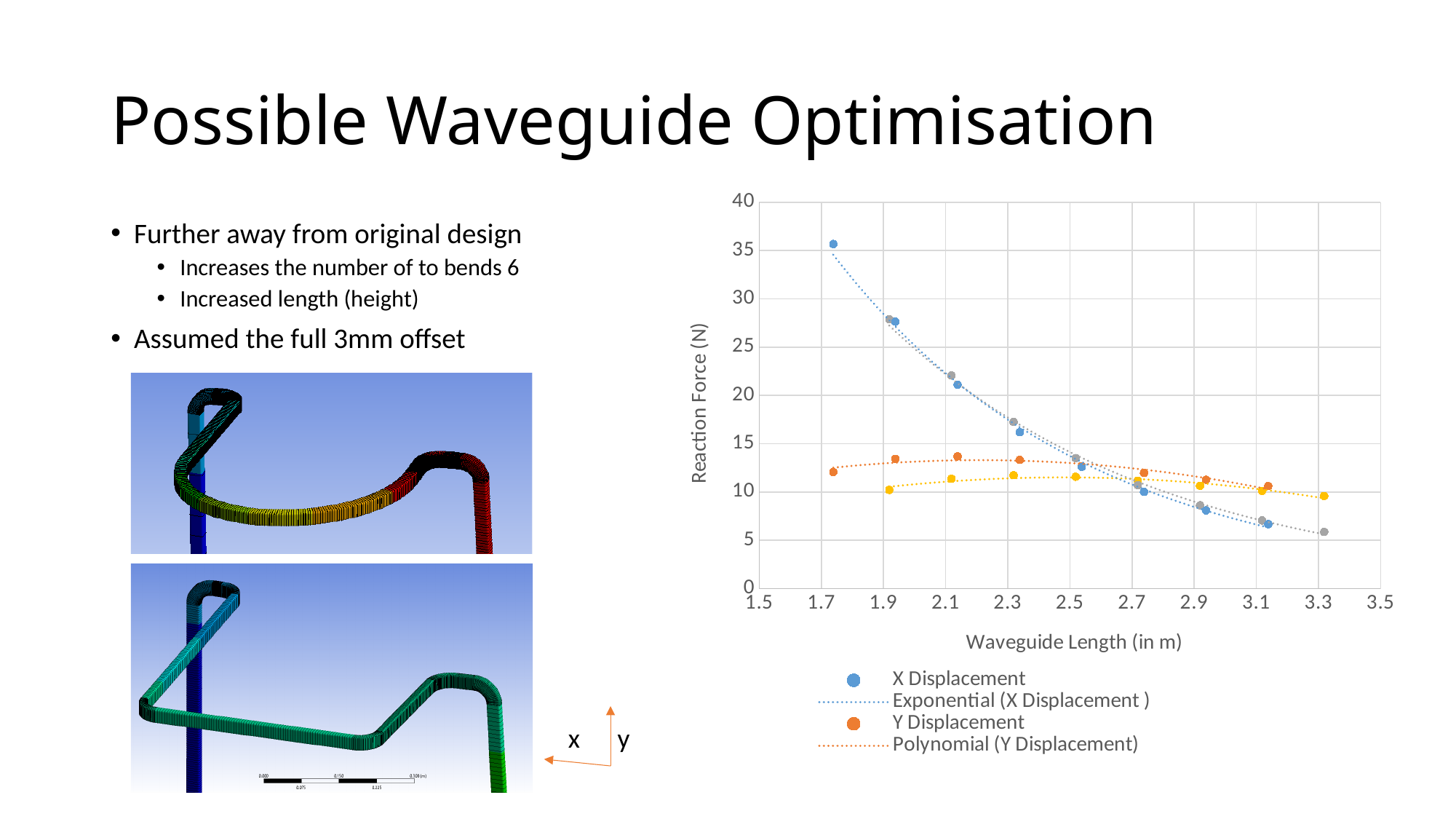
What is the title of the y axis of the chart? Reaction Force (N) Is the Y Displacement value at a waveguide length of about 2.1 m greater or less than 15? less Is the X Displacement value at the shortest waveguide length (around 1.7 m) greater or less than 30? greater What kind of chart is shown on the slide? scatter chart Is the Y Displacement value at a waveguide length of about 2.1 m greater or less than 10? greater Does the X Displacement reaction force rise or fall as waveguide length increases? fall How many X Displacement data points are plotted on the chart? 8 What is the title of the x axis of the chart? Waveguide Length (in m) At a waveguide length of about 1.7 m, which is larger: X Displacement or Y Displacement? X Displacement At a waveguide length of about 3.1 m, which is larger: X Displacement or Y Displacement? Y Displacement How many entries does the chart legend list? 4